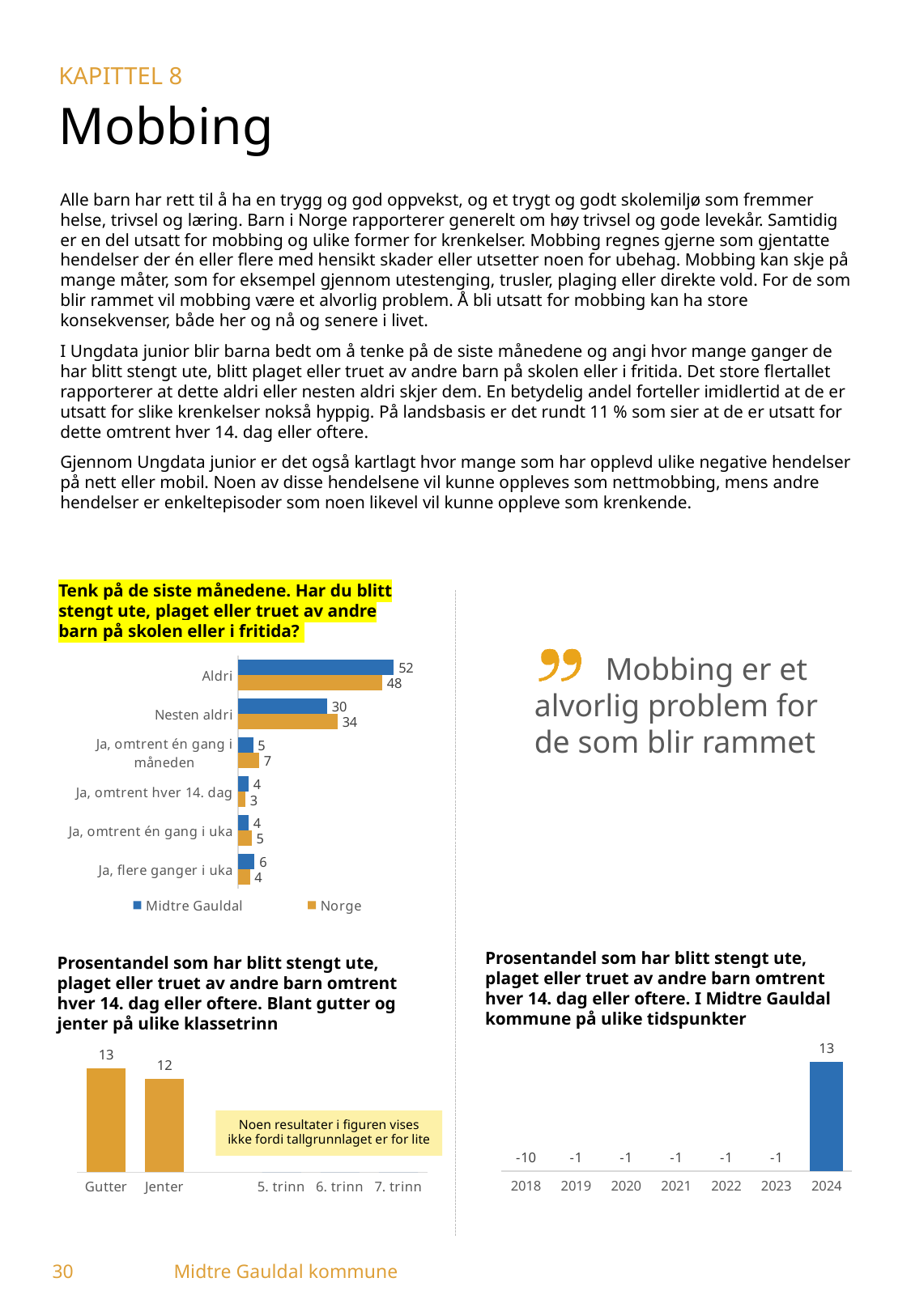
In the chart 'Tenk på de siste månedene. Har du blitt stengt ute, plaget eller truet av andre barn på skolen eller i fritida?', what is the value for Midtre Gauldal in the category 'Aldri'? 52 What kind of chart is the chart 'Tenk på de siste månedene...'? Bar chart In the chart 'Tenk på de siste månedene...', how many categories are shown? 6 In the chart 'Tenk på de siste månedene...', what is the value for Norge in the category 'Nesten aldri'? 34 In the chart 'Tenk på de siste månedene...', which category has the highest value for Midtre Gauldal? Aldri In the chart 'Prosentandel ... Blant gutter og jenter på ulike klassetrinn', what is the value for Gutter? 13 In the chart 'Tenk på de siste månedene...', what is the difference between the Midtre Gauldal and Norge values for 'Aldri'? 4 In the chart 'Tenk på de siste månedene...', which colour represents Norge? Orange In the chart 'Prosentandel ... I Midtre Gauldal kommune på ulike tidspunkter', what is the value for 2024? 13 In the chart 'Tenk på de siste månedene...', which is larger for 'Ja, omtrent én gang i måneden': Midtre Gauldal or Norge? Norge In the chart 'Tenk på de siste månedene...', how many series does the legend list? 2 In the chart 'Prosentandel ... Blant gutter og jenter på ulike klassetrinn', which is larger: Gutter or Jenter? Gutter